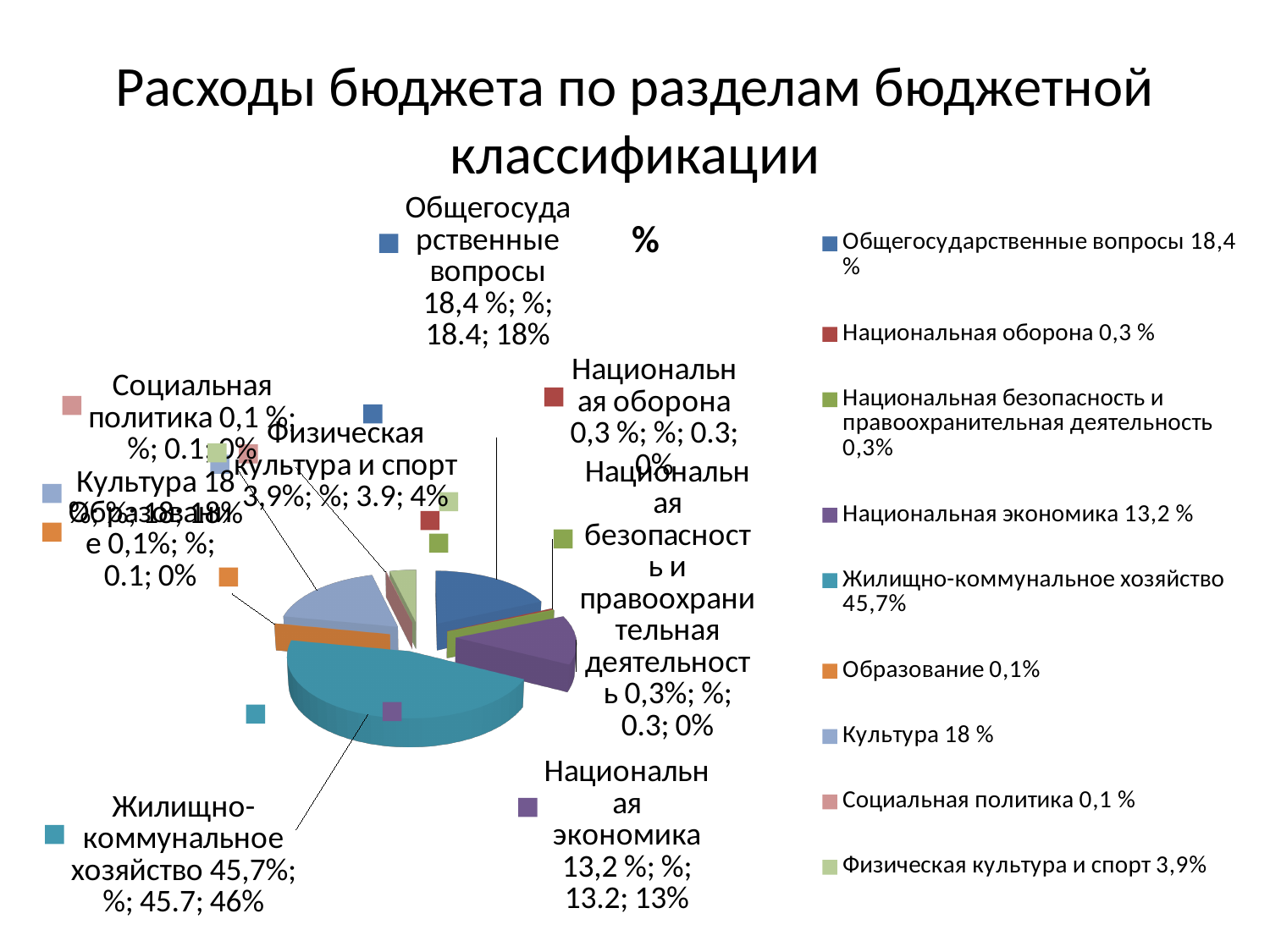
What is the title of the slide? Расходы бюджета по разделам бюджетной классификации What value is shown for Физическая культура и спорт in the legend? 3,9% According to its data label, what percentage share of the pie does Жилищно-коммунальное хозяйство have? 46% What value is shown for Общегосударственные вопросы in the legend? 18,4 % How many categories does the legend of the pie chart list? 9 What kind of chart is shown on the slide? Pie chart What is the difference between the values for Жилищно-коммунальное хозяйство (45,7) and Общегосударственные вопросы (18,4)? 27,3 What value is shown for Национальная экономика in the legend? 13,2 % Which is larger: Общегосударственные вопросы or Национальная экономика? Общегосударственные вопросы What value is shown for Жилищно-коммунальное хозяйство in the legend? 45,7% Which category has the largest slice of the pie chart? Жилищно-коммунальное хозяйство What colour is the slice for Национальная экономика? Purple